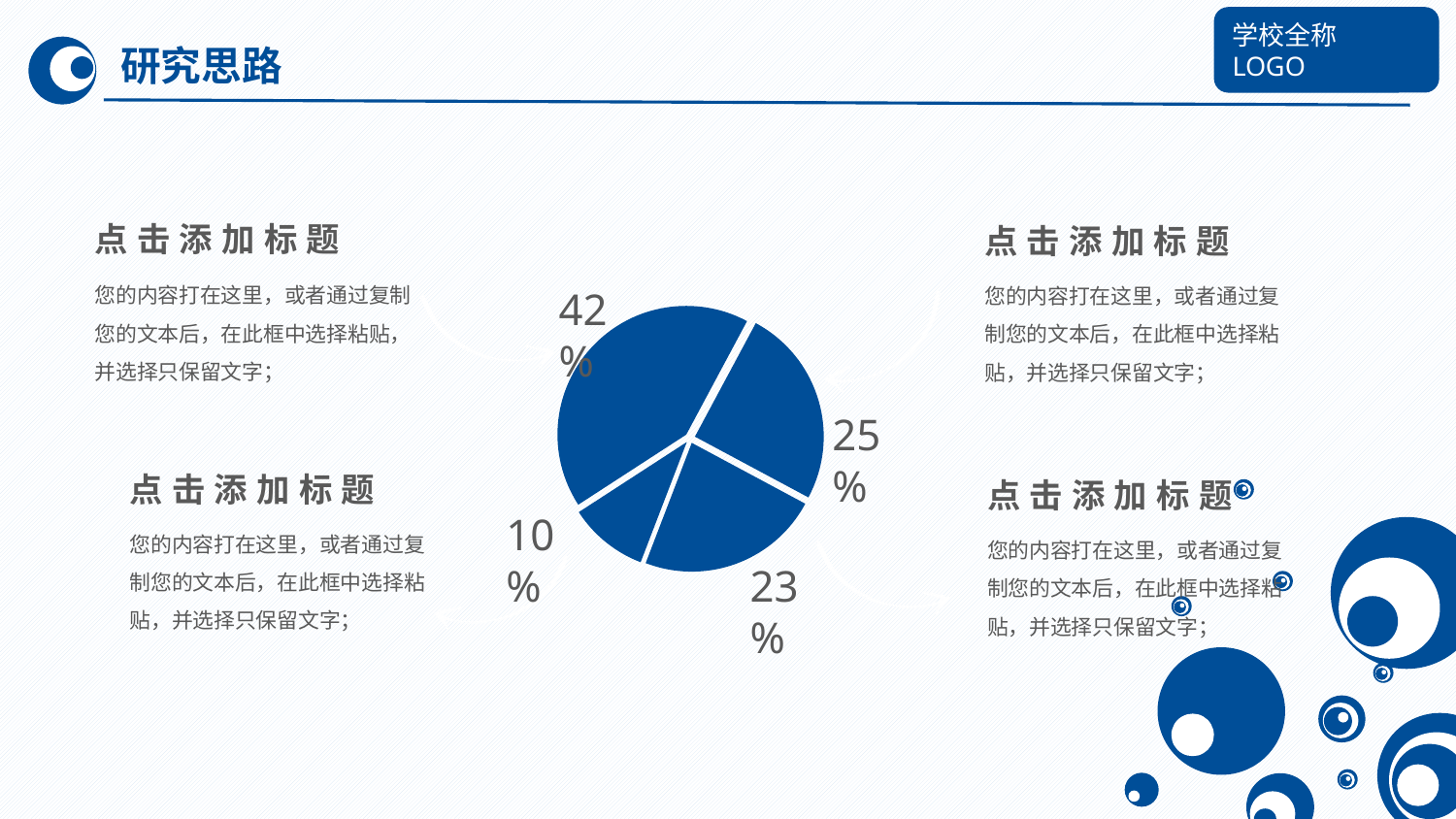
What percentage is shown on the slice at the lower right of the pie chart? 23% What do the four percentage labels on the pie chart add up to? 100% Which slice is larger in the pie chart: the one labelled 25% or the one labelled 23%? 25% What is the percentage shown on the smallest slice of the pie chart? 10% What kind of chart is shown on the slide? pie chart Does the pie chart have a legend? No How many slices does the pie chart have? 4 What percentage is shown on the slice at the lower left of the pie chart? 10% What is the difference in percentage points between the largest slice (42%) and the smallest slice (10%) of the pie chart? 32 What colour are the slices of the pie chart? dark blue What is the percentage shown on the largest slice of the pie chart? 42% What is the difference in percentage points between the slices labelled 25% and 23% in the pie chart? 2